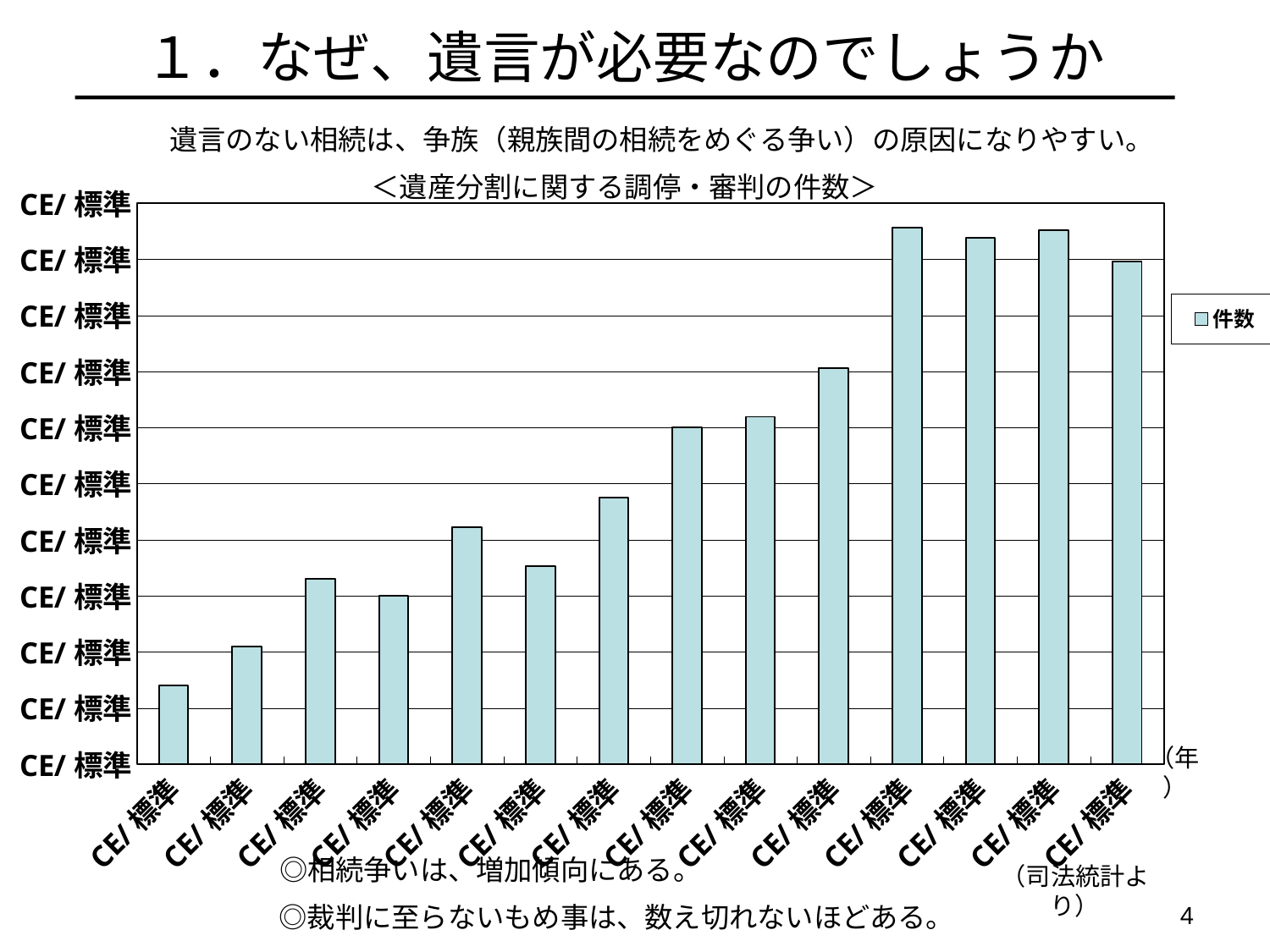
Which is larger, the 4th bar from the left or the 5th bar from the left? the 5th bar Which is larger, the 10th bar from the left or the 11th bar from the left? the 11th bar Overall, do the bar values rise or fall from left to right along the x axis? rise Which is larger, the first bar on the left or the last bar on the right? the last bar on the right How many bars are plotted in the chart? 14 What is the name of the series shown in the legend? 件数 What kind of chart is shown on the slide? bar chart Counting from the left, which bar is the lowest in the chart? the 1st bar What is the title printed above the chart? ＜遺産分割に関する調停・審判の件数＞ How many series does the chart's legend list? 1